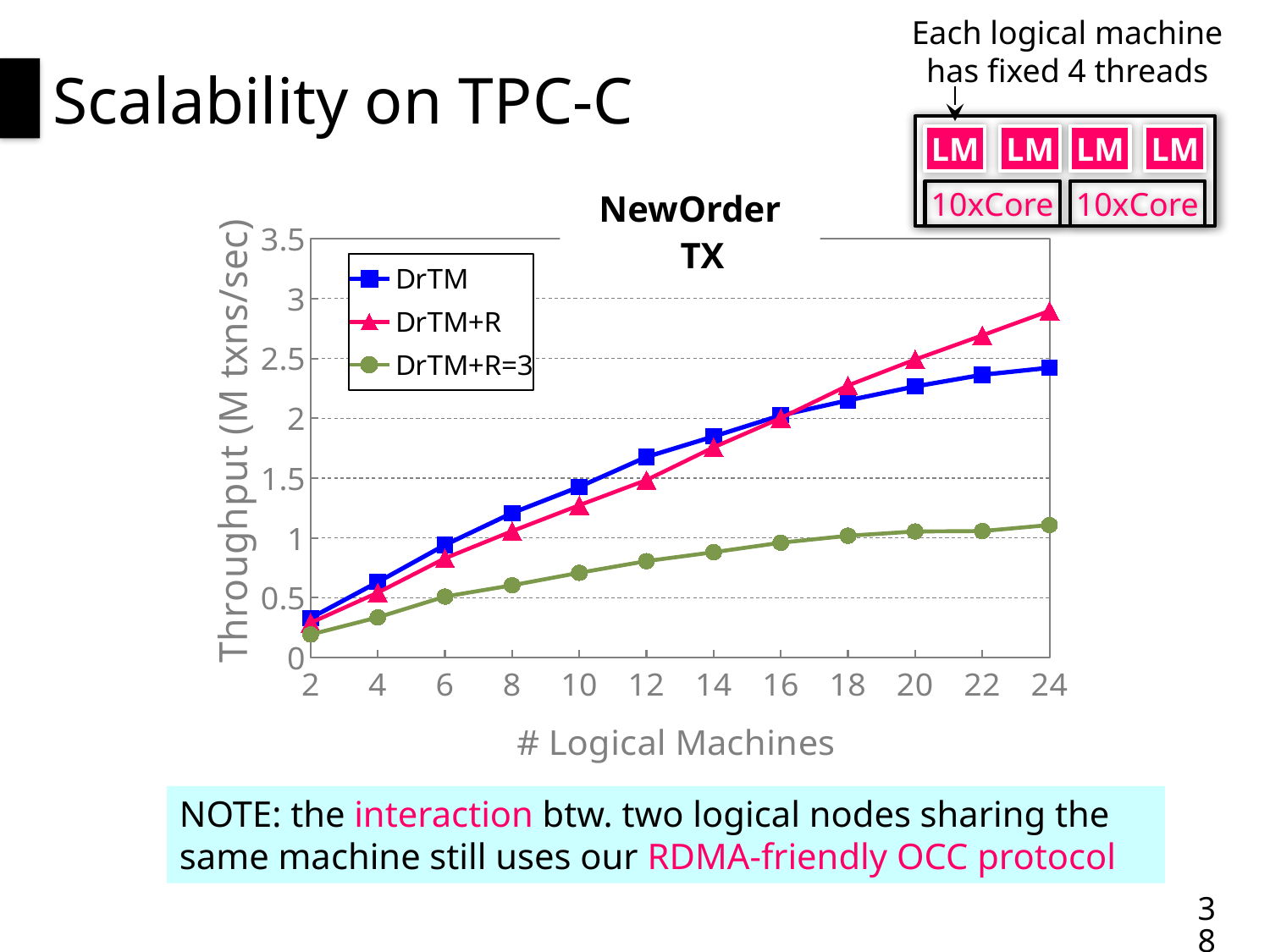
How many data points are plotted for the DrTM series? 12 Is the throughput of DrTM+R at 24 logical machines greater or less than 2.5? greater What is the label of the y axis? Throughput (M txns/sec) Does the throughput of DrTM+R rise or fall as the number of logical machines increases? rise At 24 logical machines, which has higher throughput, DrTM or DrTM+R? DrTM+R How many series does the legend list? 3 Is the throughput of DrTM+R=3 at 24 logical machines greater or less than 1.5? less At 8 logical machines, which has higher throughput, DrTM or DrTM+R=3? DrTM Is the throughput of DrTM at 12 logical machines greater or less than 1.5? greater What kind of chart is shown on the slide? line chart Which series has the lowest throughput at 24 logical machines? DrTM+R=3